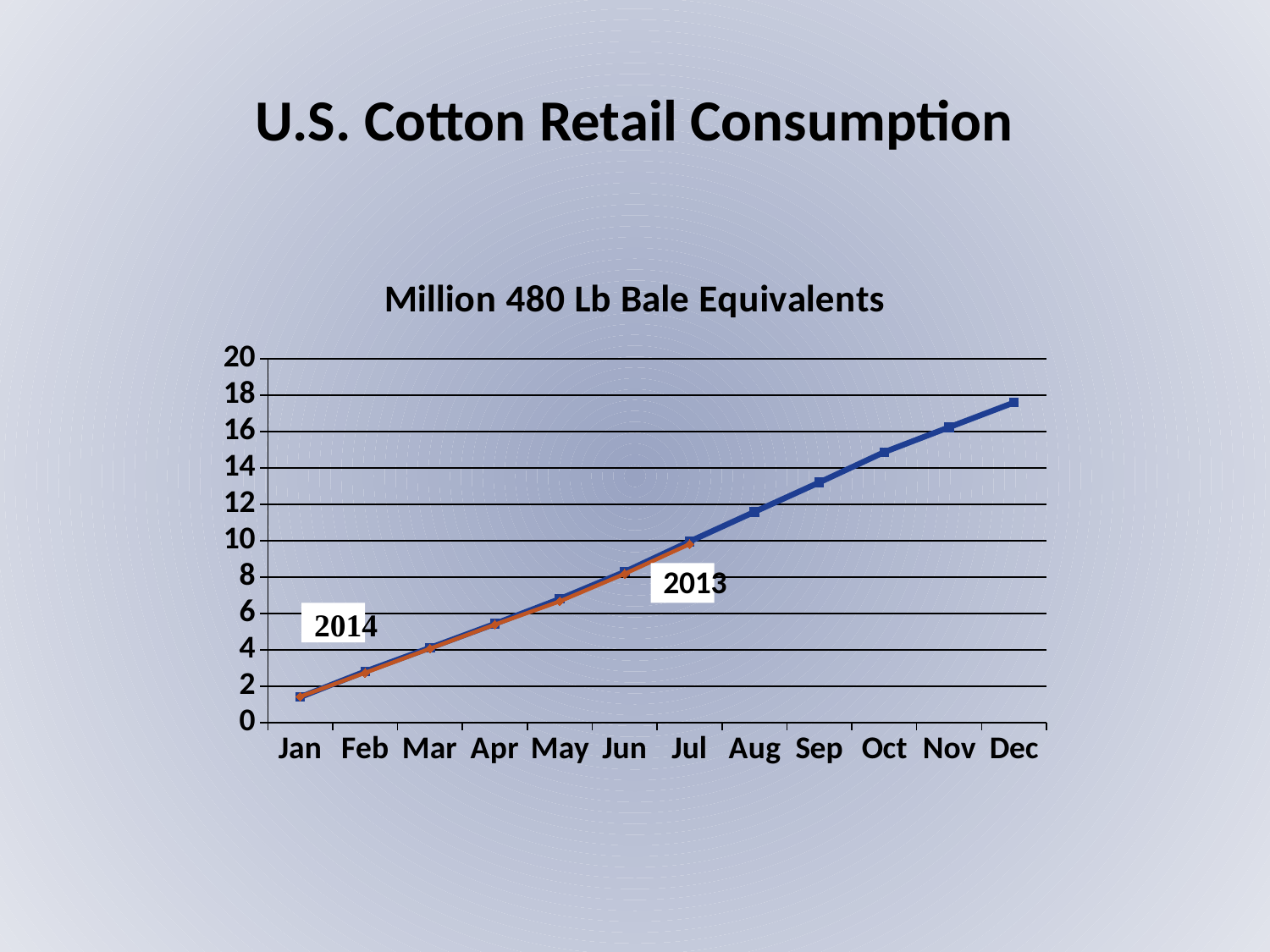
How many series (years) are plotted on the chart? 2 Do the values for 2013 rise or fall from Jan to Dec? rise How many months are shown on the x axis? 12 Is the 2013 value for Jan greater or less than 2? less In which month is the 2013 value highest? Dec Is the 2013 value for Aug greater or less than 10? greater Which year's line extends through Dec, 2013 or 2014? 2013 Is the 2013 value for Sep greater or less than 14? less What unit is given in the chart's title? Million 480 Lb Bale Equivalents In which month is the 2013 value lowest? Jan What kind of chart is shown on the slide? line chart